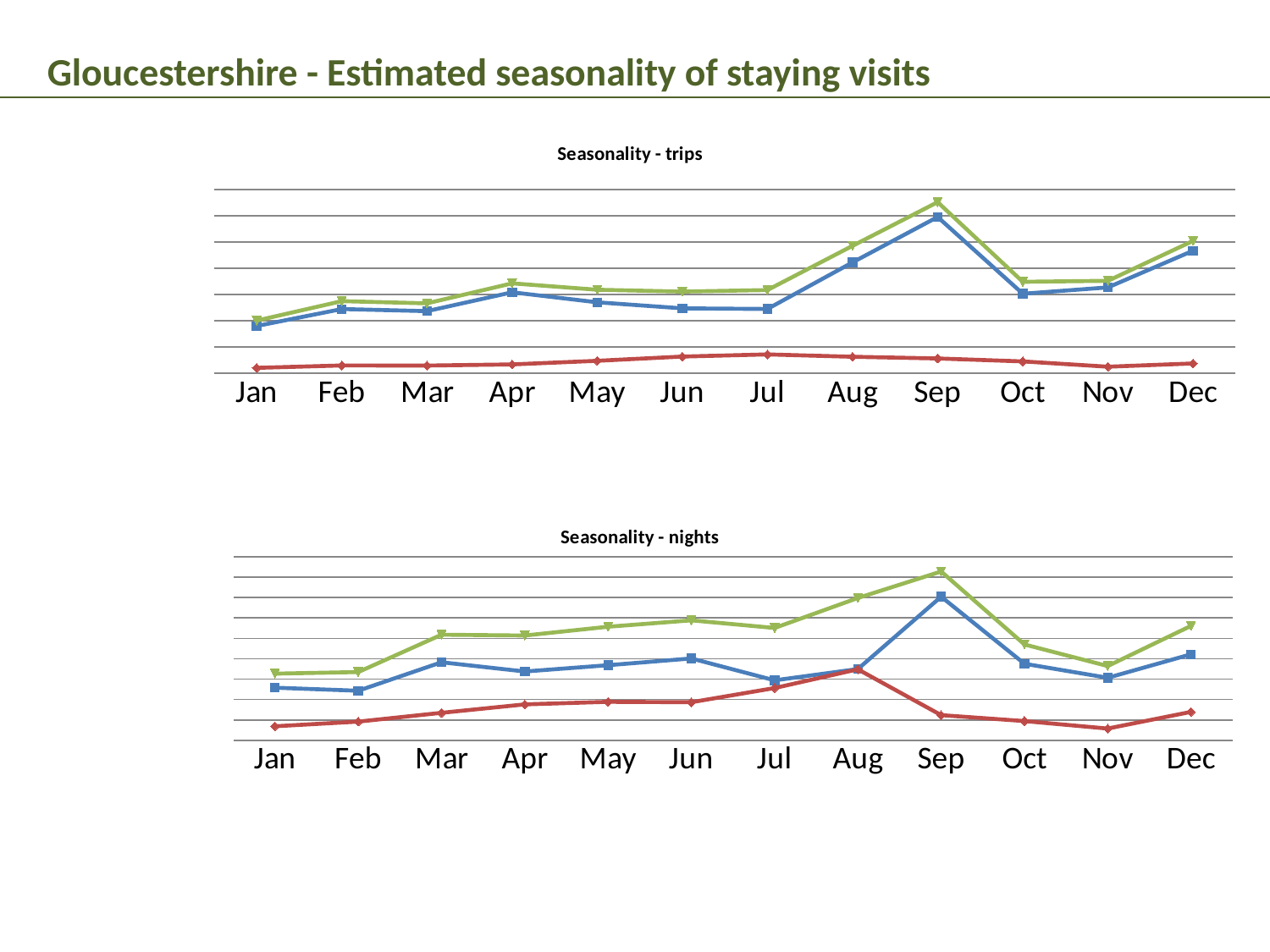
What kind of chart is the 'Seasonality - nights' chart? line chart In the 'Seasonality - nights' chart, in which month does the green line reach its highest point? Sep In the 'Seasonality - nights' chart, is the blue line higher in Aug or in Sep? Sep In the 'Seasonality - trips' chart, in which month does the blue line reach its highest point? Sep In the 'Seasonality - trips' chart, in which month does the red line reach its highest point? Jul What kind of chart is the 'Seasonality - trips' chart? line chart In the 'Seasonality - trips' chart, in which month is the green line at its lowest? Jan How many months are shown on the x axis of the 'Seasonality - trips' chart? 12 In the 'Seasonality - trips' chart, does the green line rise or fall from Sep to Oct? fall How many lines are plotted on the 'Seasonality - nights' chart? 3